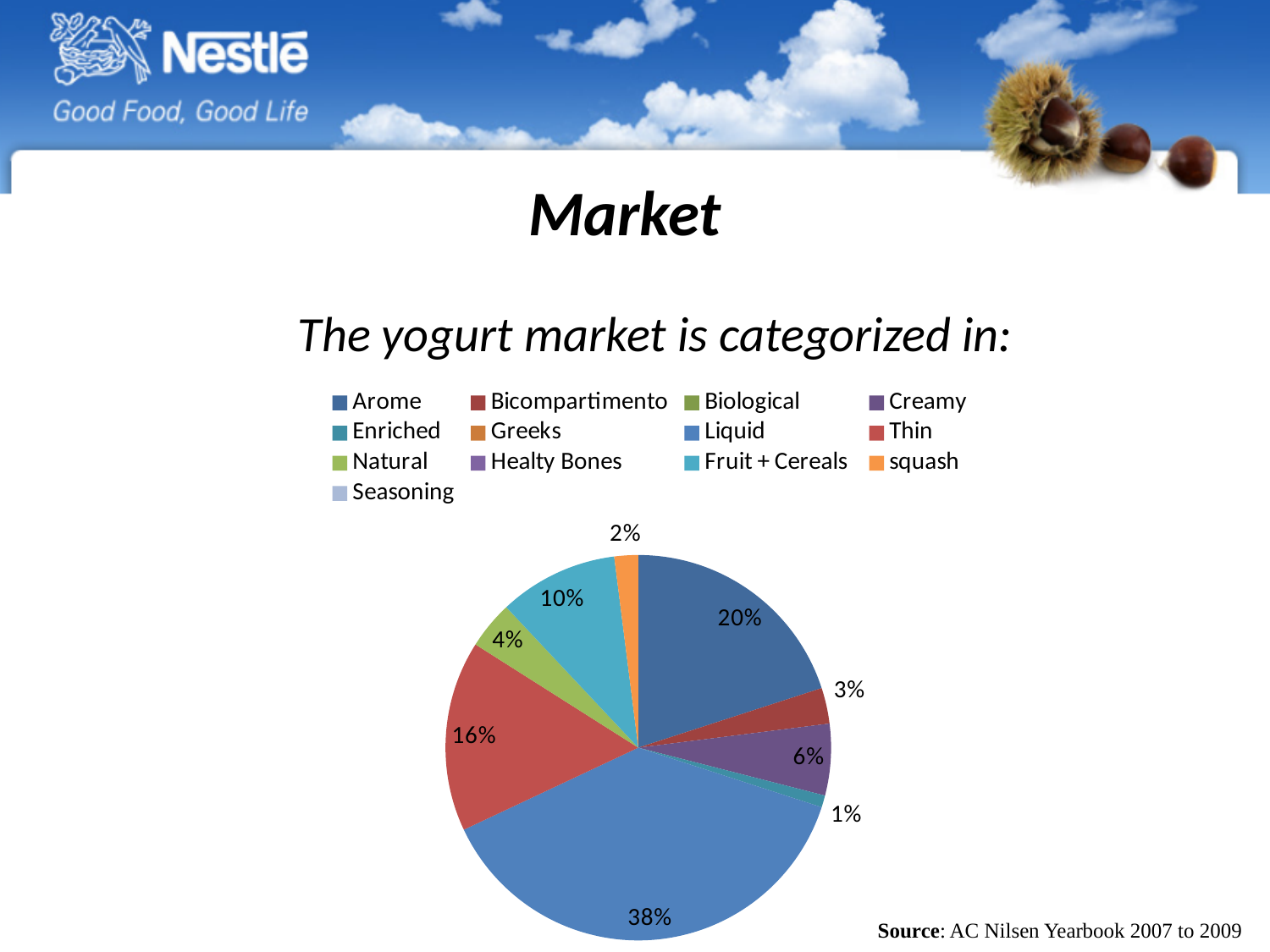
What share of the pie does the Liquid slice (blue) have? 38% How many entries does the legend of the pie chart list? 13 Which slice is larger, the Thin slice (16%) or the Creamy slice (6%)? Thin What source is cited for the chart data? AC Nilsen Yearbook 2007 to 2009 What is the largest percentage shown on the pie chart? 38% How many slices of the pie chart have a percentage label? 9 What is the smallest percentage labelled on the pie chart? 1% What kind of chart is shown on the slide? pie chart What percentage is shown for the Fruit + Cereals slice (cyan)? 10% What percentage is shown for the Thin slice (red)? 16% What is the difference in percentage points between the largest slice (38%) and the Arome slice (20%)? 18 What share of the pie does the Arome slice (dark blue) have? 20%